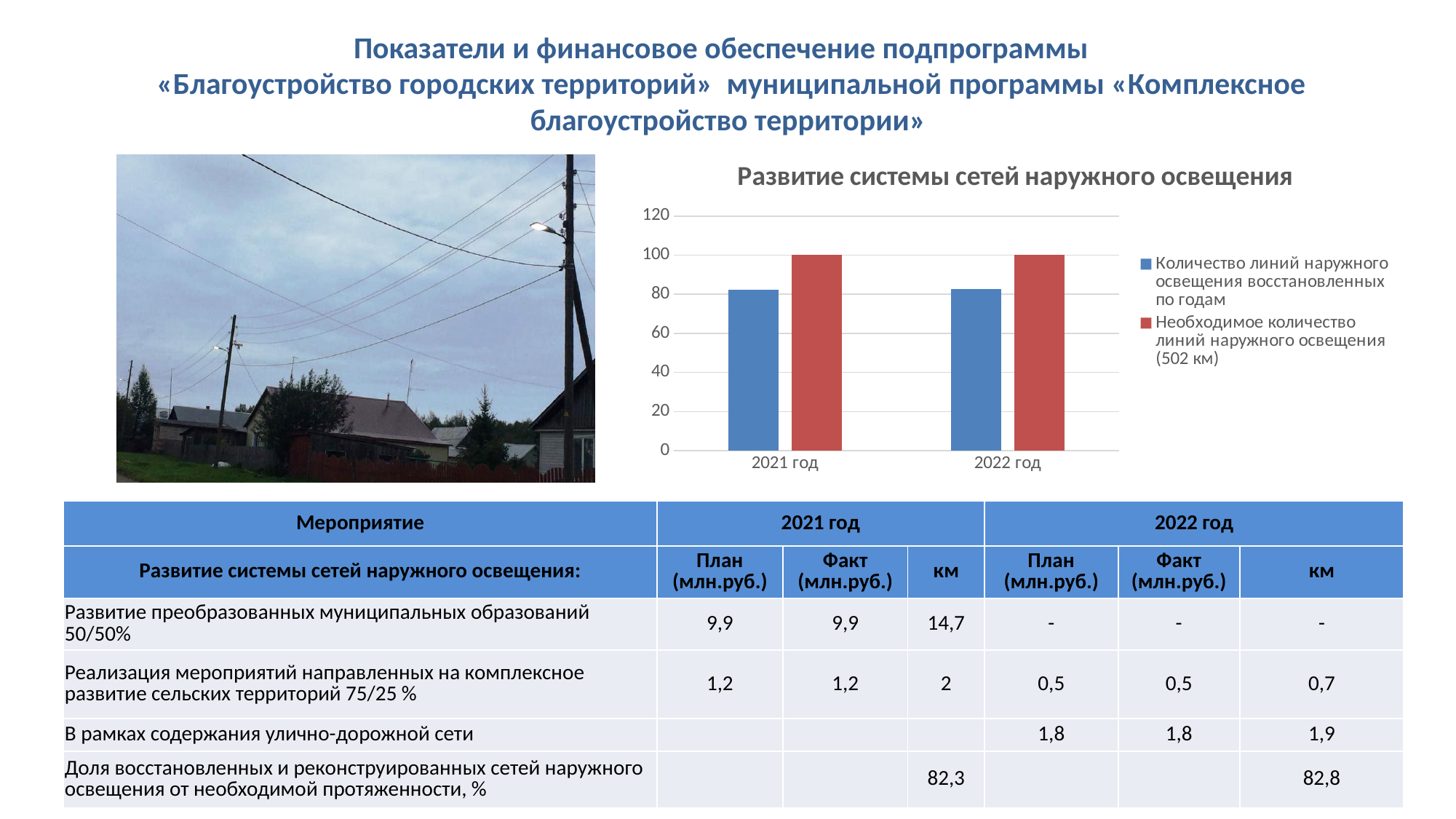
Is the value for "Количество линий наружного освещения восстановленных по годам" in 2022 год greater or less than 100? less In 2022 год, which series has the smaller value? Количество линий наружного освещения восстановленных по годам How many categories are shown on the x axis of the chart? 2 Which colour represents the series "Необходимое количество линий наружного освещения (502 км)"? red What kind of chart is shown on the slide? bar chart What is the title of the chart? Развитие системы сетей наружного освещения In 2021 год, which series has the larger value: "Количество линий наружного освещения восстановленных по годам" or "Необходимое количество линий наружного освещения (502 км)"? Необходимое количество линий наружного освещения (502 км) Is the value for "Количество линий наружного освещения восстановленных по годам" in 2021 год greater or less than 80? greater Is the value for "Необходимое количество линий наружного освещения (502 км)" in 2021 год greater or less than 80? greater How many series does the chart legend list? 2 What is the highest value shown on the chart's vertical axis? 120